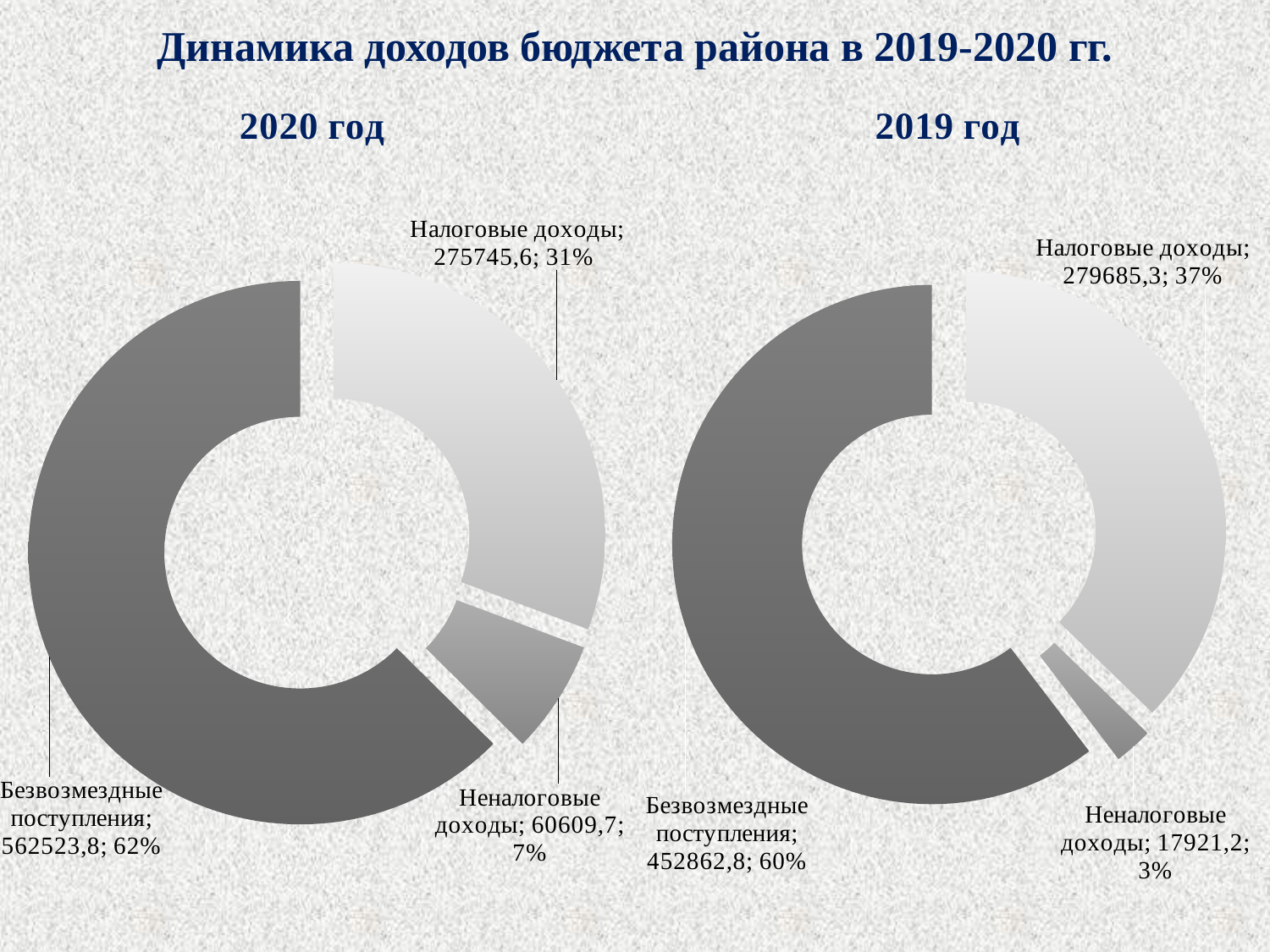
In the 2020 год chart, what is the value for Налоговые доходы? 275745,6 Which is larger: Налоговые доходы in the 2019 год chart or in the 2020 год chart? 2019 год How many categories does the 2019 год chart show? 3 In the 2019 год chart, what is the value for Неналоговые доходы? 17921,2 In the 2019 год chart, which category has the smallest value? Неналоговые доходы In the 2020 год chart, which category has the largest value? Безвозмездные поступления In the 2020 год chart, what share of the total do Безвозмездные поступления make up? 62% What is the difference between Неналоговые доходы in the 2020 год chart and in the 2019 год chart? 42688,5 What is the title of the slide? Динамика доходов бюджета района в 2019-2020 гг. What kind of chart is the 2020 год chart? Pie chart (doughnut) In the 2019 год chart, what share of the total do Налоговые доходы make up? 37% In the 2020 год chart, what is the difference between Безвозмездные поступления and Налоговые доходы? 286778,2